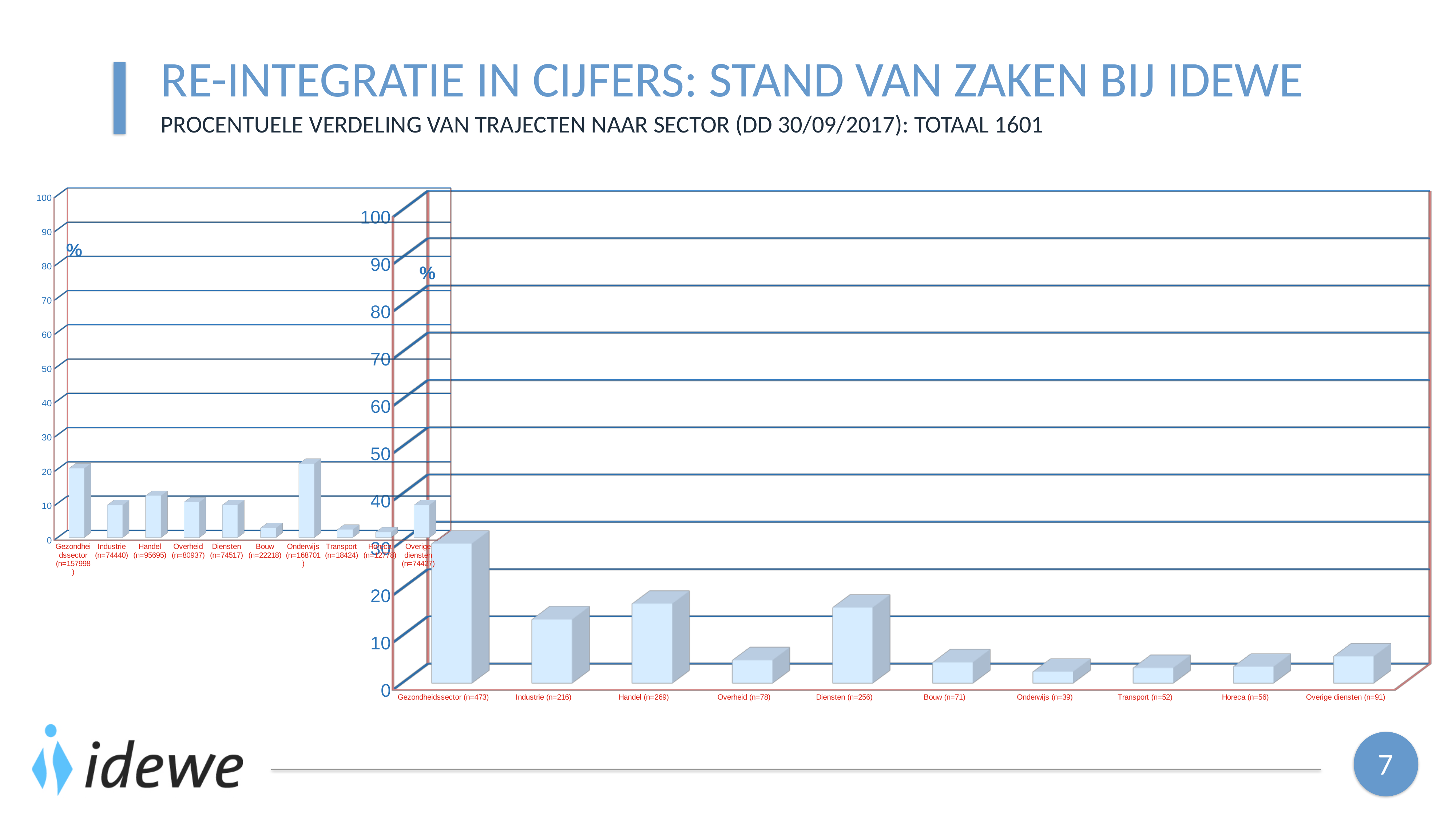
In the larger chart on the right, is the value for Onderwijs (n=39) greater or less than 10? less In the larger chart on the right, is the value for Gezondheidssector (n=473) greater or less than 40? less In the larger chart on the right, which sector has the highest value? Gezondheidssector (n=473) How many sector categories does the smaller chart on the left show? 10 In the larger chart on the right, which is larger: the value for Handel (n=269) or the value for Overheid (n=78)? Handel (n=269) In the larger chart on the right, is the value for Industrie (n=216) greater or less than 20? less What kind of chart is the larger chart on the right of the slide? bar chart What total number of trajecten is stated in the slide subtitle? 1601 In the smaller chart on the left, which is larger: the value for Handel (n=95695) or the value for Bouw (n=22218)? Handel (n=95695) How many sector categories does the larger chart on the right show? 10